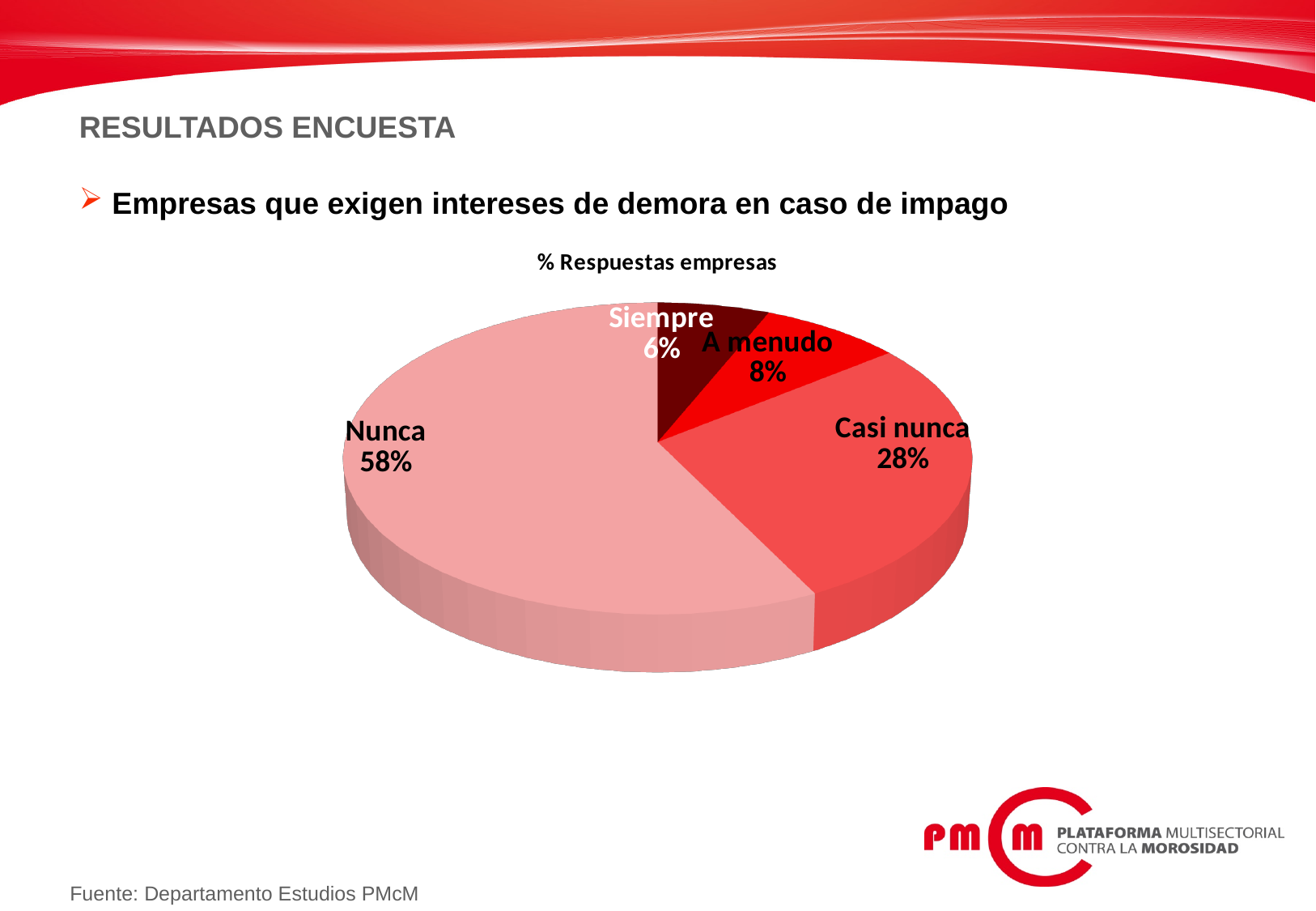
How many slices does the pie chart have? 4 Which is larger, the share for "A menudo" or the share for "Siempre"? A menudo What percentage of companies answered "Siempre"? 6% What is the combined share of "A menudo" and "Siempre"? 14% Which response has the smallest share of the pie? Siempre What is the difference in percentage points between "Nunca" and "Casi nunca"? 30 What is the title of the chart? % Respuestas empresas Which response has the largest share of the pie? Nunca What percentage of companies answered "Casi nunca"? 28% What percentage of companies answered "Nunca"? 58% What percentage of companies answered "A menudo"? 8% What kind of chart is shown on the slide? Pie chart